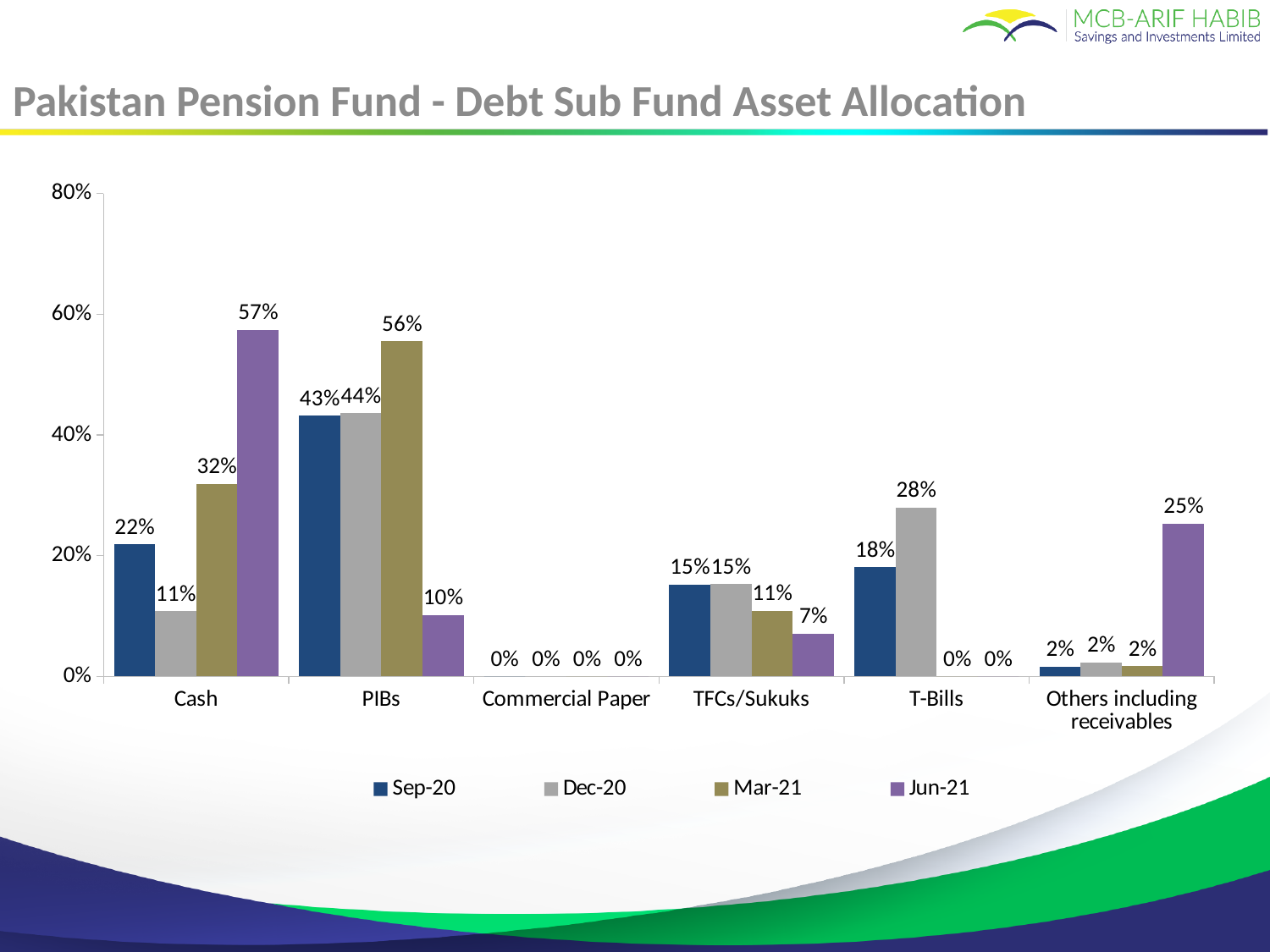
Which category has the highest Jun-21 value? Cash How many categories are shown on the x axis? 6 What is the Mar-21 value for PIBs? 56% What kind of chart is shown on the slide? Bar chart What is the title of the slide? Pakistan Pension Fund - Debt Sub Fund Asset Allocation What is the Jun-21 value for Cash? 57% Which is larger for PIBs: the Sep-20 value or the Jun-21 value? Sep-20 Which category has the lowest Sep-20 value? Commercial Paper How many series does the legend list? 4 What is the Dec-20 value for T-Bills? 28% What is the difference between the Jun-21 and Sep-20 values for Cash? 35% What is the Jun-21 value for Others including receivables? 25%